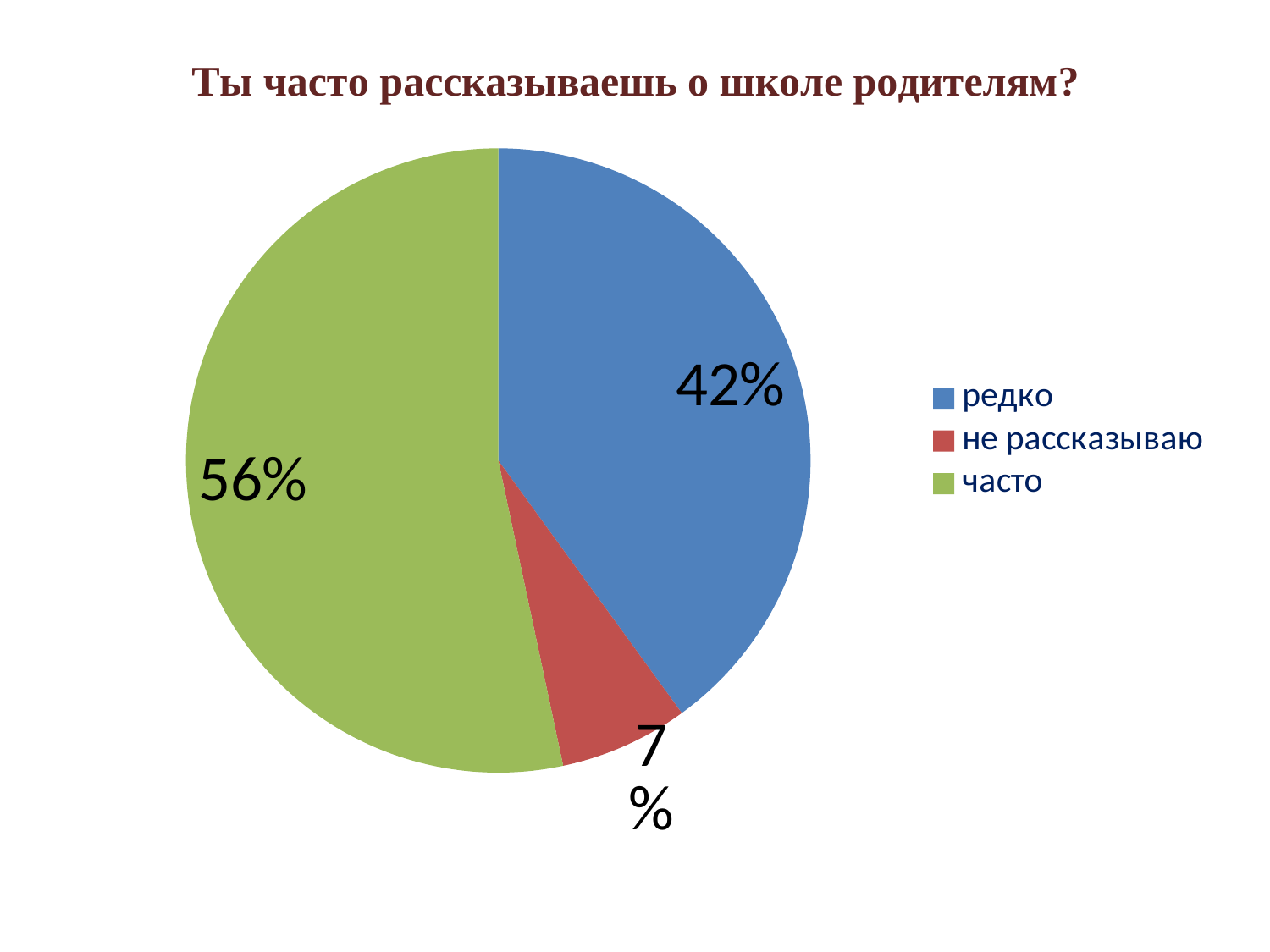
Which category has the largest share of the pie? часто What is the difference in percentage points between "редко" and "не рассказываю"? 35 How many slices does the pie chart have? 3 Which is larger, the share for "редко" or the share for "часто"? часто What percentage of the pie is labelled for "часто"? 56% Which category has the smallest share of the pie? не рассказываю What percentage of the pie is labelled for "редко"? 42% What is the difference in percentage points between "часто" and "редко"? 14 Which colour represents "не рассказываю" in the legend? red What percentage of the pie is labelled for "не рассказываю"? 7% What kind of chart is shown on the slide? pie chart What is the title of the chart? Ты часто рассказываешь о школе родителям?